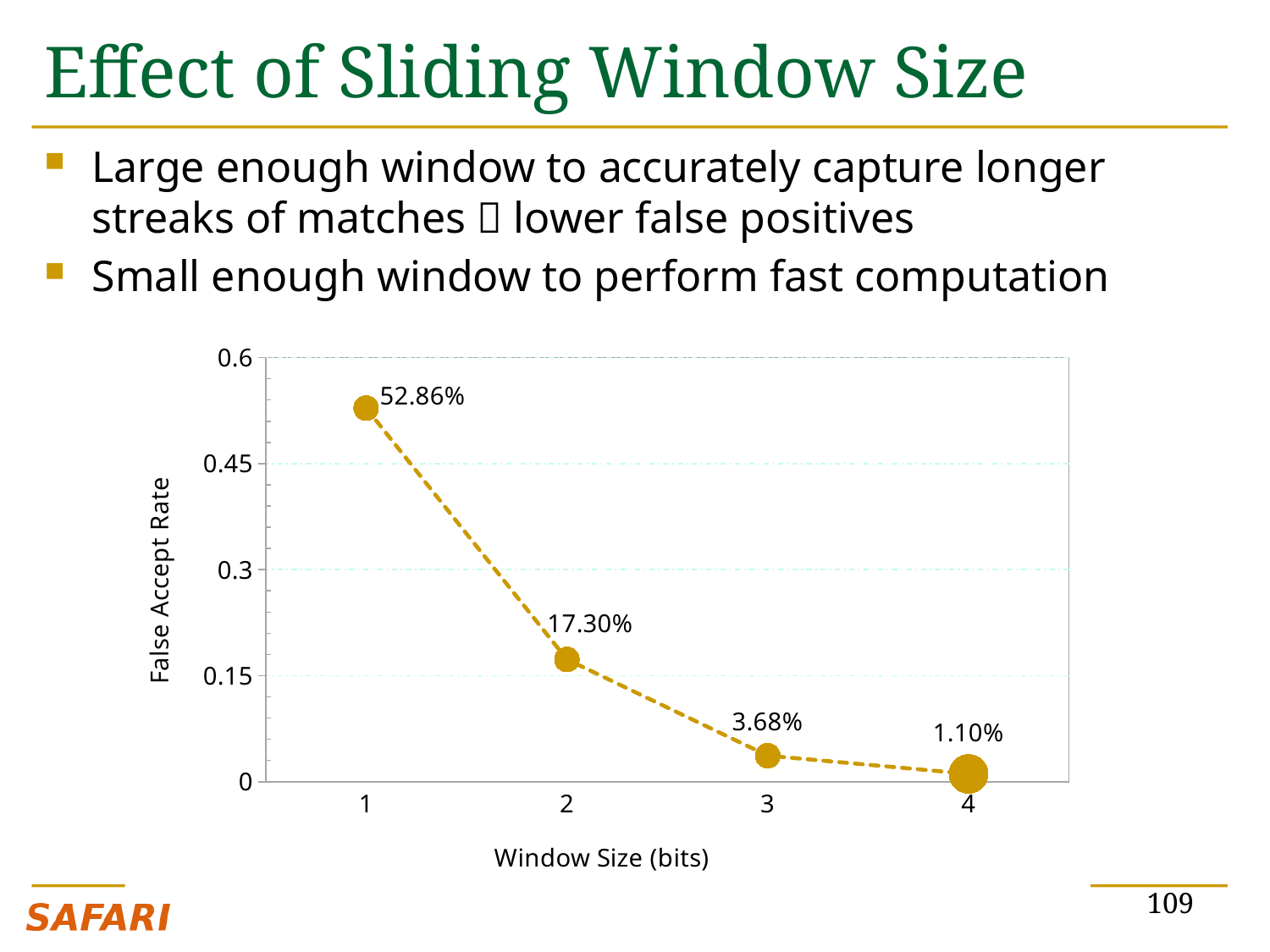
Does the false accept rate rise or fall as the window size increases? Falls What is the false accept rate for a window size of 2 bits? 17.30% Which window size has the lowest false accept rate? 4 How many window sizes are plotted on the chart? 4 Which window size has the highest false accept rate? 1 What is the difference in false accept rate between window size 1 and window size 2? 35.56% Is the false accept rate for window size 2 greater or less than 0.15? greater What kind of chart is shown on the slide? Line chart Which has a larger false accept rate, window size 3 or window size 4? Window size 3 What is the false accept rate for a window size of 4 bits? 1.10% What is the false accept rate for a window size of 1 bit? 52.86% What is the false accept rate for a window size of 3 bits? 3.68%